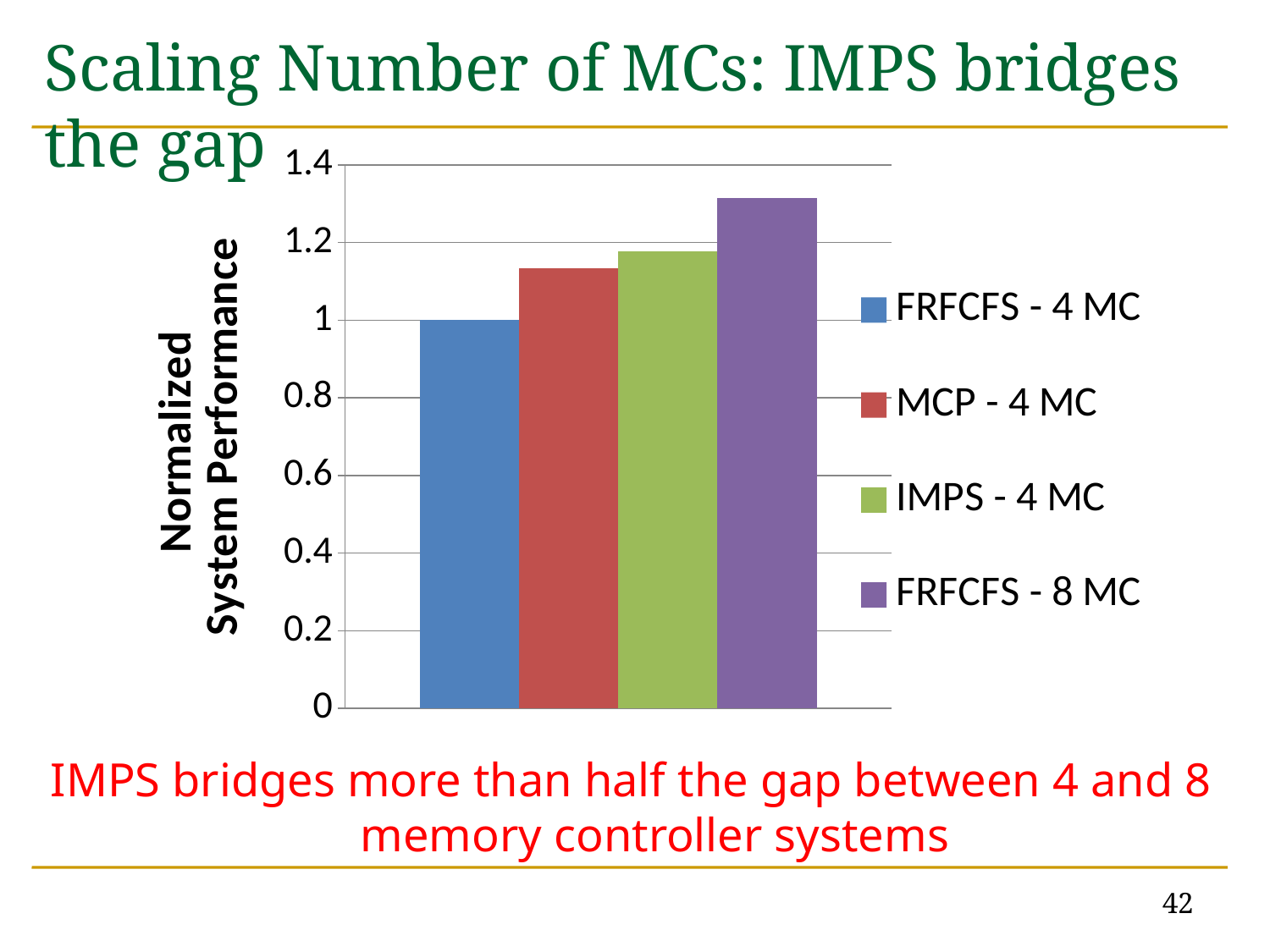
Which series has the lowest normalized system performance? FRFCFS - 4 MC Is the value for FRFCFS - 8 MC greater or less than 1.2? greater Which is larger, the value for FRFCFS - 8 MC or the value for IMPS - 4 MC? FRFCFS - 8 MC How many bars are plotted in the chart? 4 Which series has the highest normalized system performance? FRFCFS - 8 MC Is the value for IMPS - 4 MC greater or less than 1.2? less Is the value for MCP - 4 MC greater or less than 1? greater What is the label of the vertical axis? Normalized System Performance What colour is the bar for IMPS - 4 MC? green How many series does the legend list? 4 What is the normalized system performance for FRFCFS - 4 MC? 1 What kind of chart is shown on the slide? bar chart